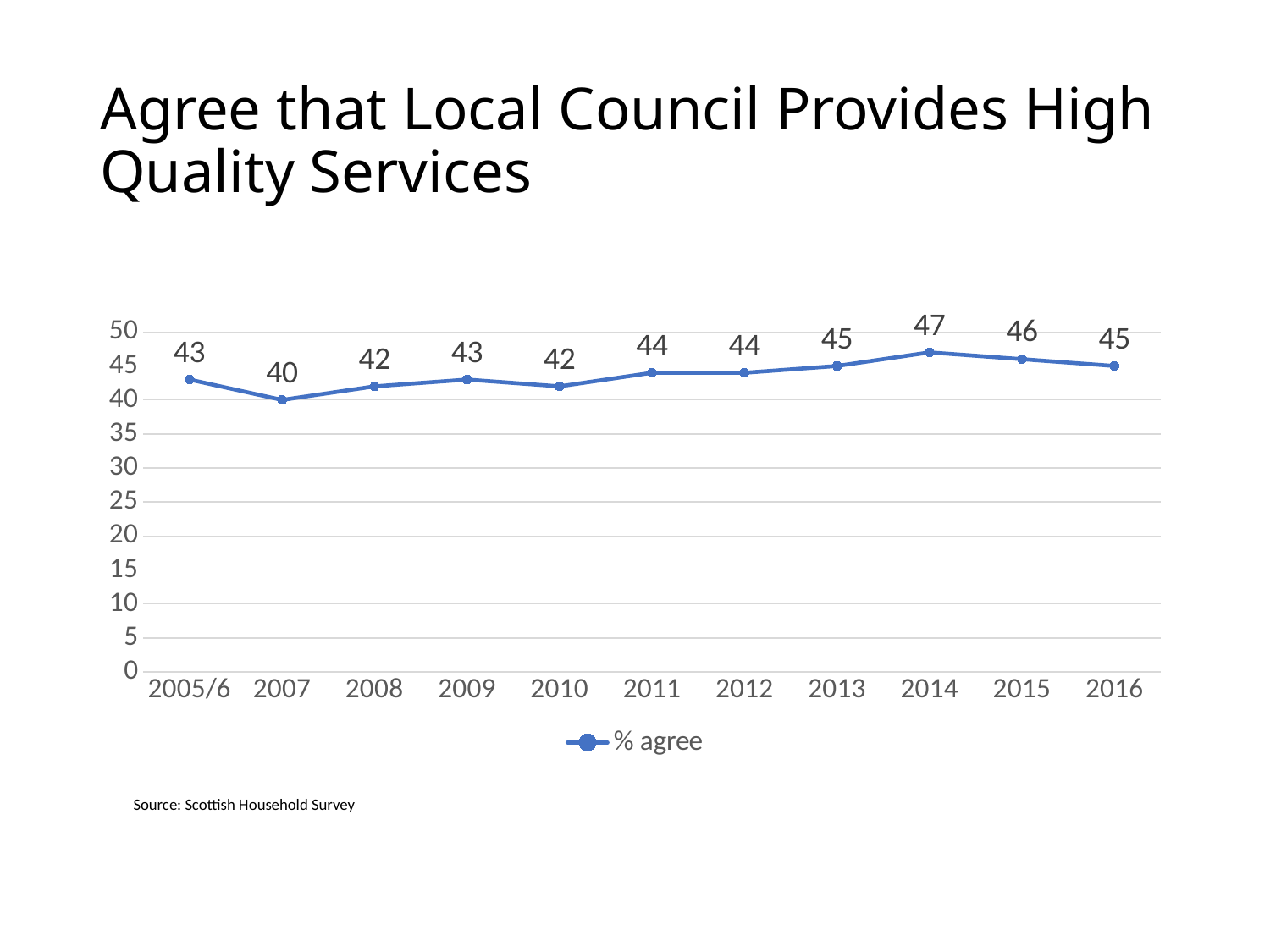
What is the value for 2016? 45 What is the difference between the values for 2014 and 2007? 7 Which year has the lowest value? 2007 Which year has the highest value? 2014 How many series does the legend list? 1 What is the name of the series shown in the legend? % agree What kind of chart is shown? line chart What is the value for 2014? 47 How many years are plotted on the x axis? 11 What is the value for 2005/6? 43 Is the value for 2007 greater or less than 45? less Which is larger, the value for 2013 or the value for 2010? 2013